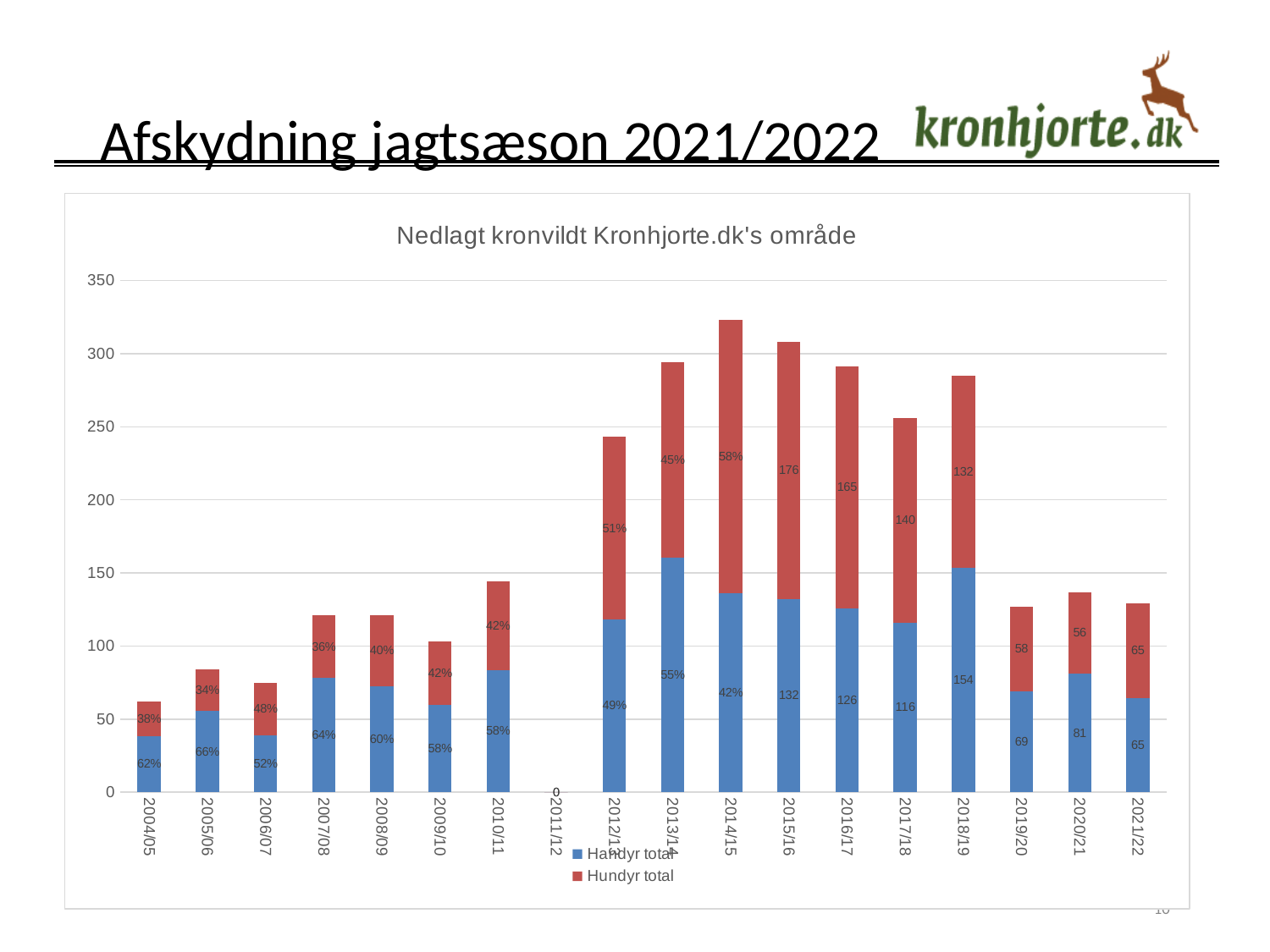
What is the title of the chart? Nedlagt kronvildt Kronhjorte.dk's område What is the Handyr total value for 2018/19? 154 Which is larger for 2020/21, the Handyr total or the Hundyr total? Handyr total How many seasons (categories) are shown on the x axis? 18 Is the total stacked bar for 2013/14 greater or less than 250? greater What type of chart is shown on the slide? Stacked bar chart Which season has the lowest total value? 2011/12 How many series does the legend list? 2 What is the total of the stacked bar for 2021/22? 130 What is the Hundyr total value for 2015/16? 176 What is the total of the stacked bar for 2017/18? 256 What is the difference between the Hundyr total and the Handyr total for 2016/17? 39